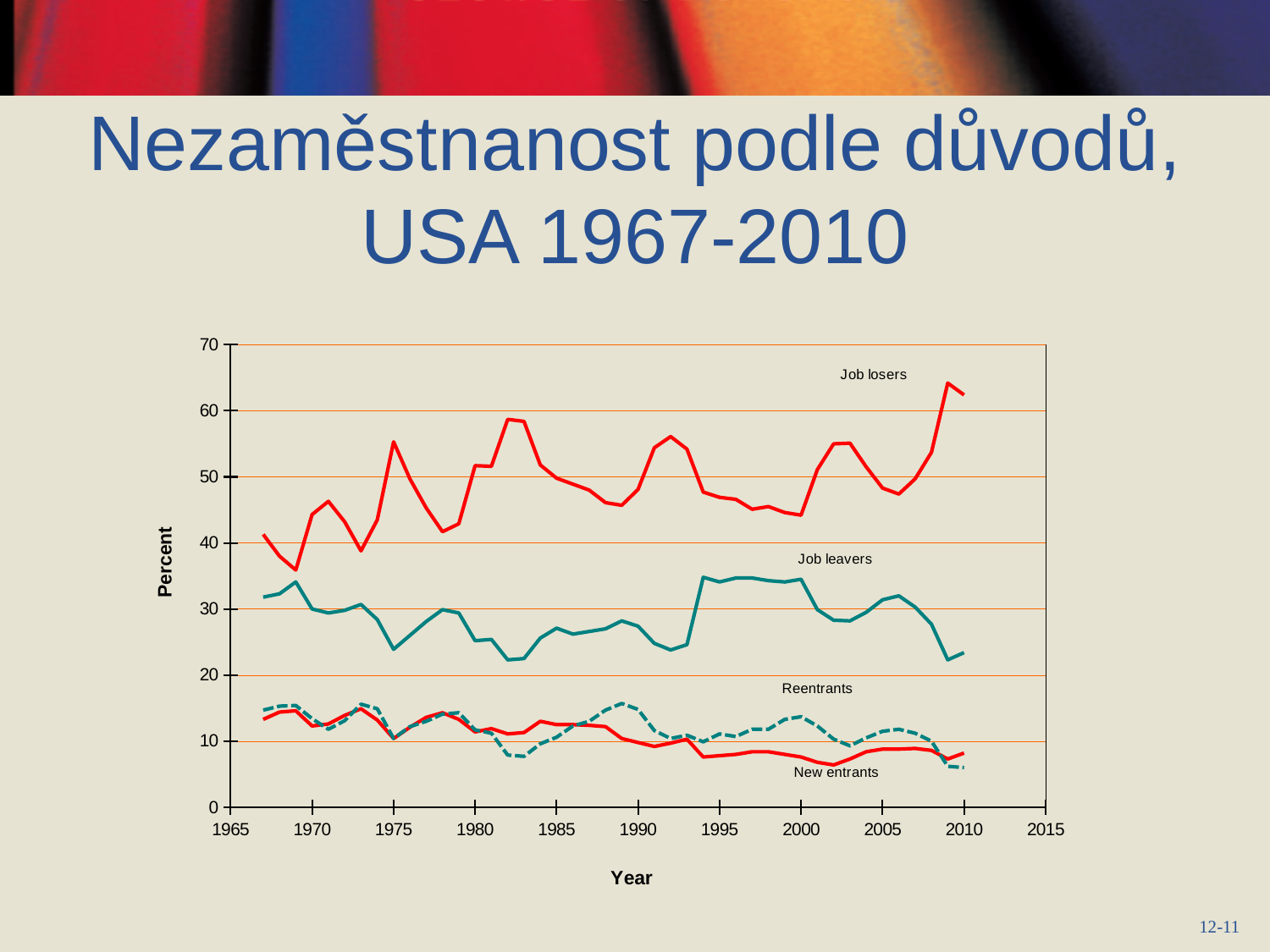
Is the value for New entrants in 2010 greater or less than 10? less Is the value for Job losers in 1969 greater or less than 40? less What is the label of the horizontal axis? Year In 2010, which is larger: Job losers or Job leavers? Job losers Is the value for Job leavers in 2009 greater or less than 30? less What is the label of the vertical axis? Percent How many series (labelled lines) are plotted on the chart? 4 Which series has the highest values throughout the chart? Job losers Do the values for Job losers rise or fall between 2006 and 2010? rise What kind of chart is shown on the slide? line chart